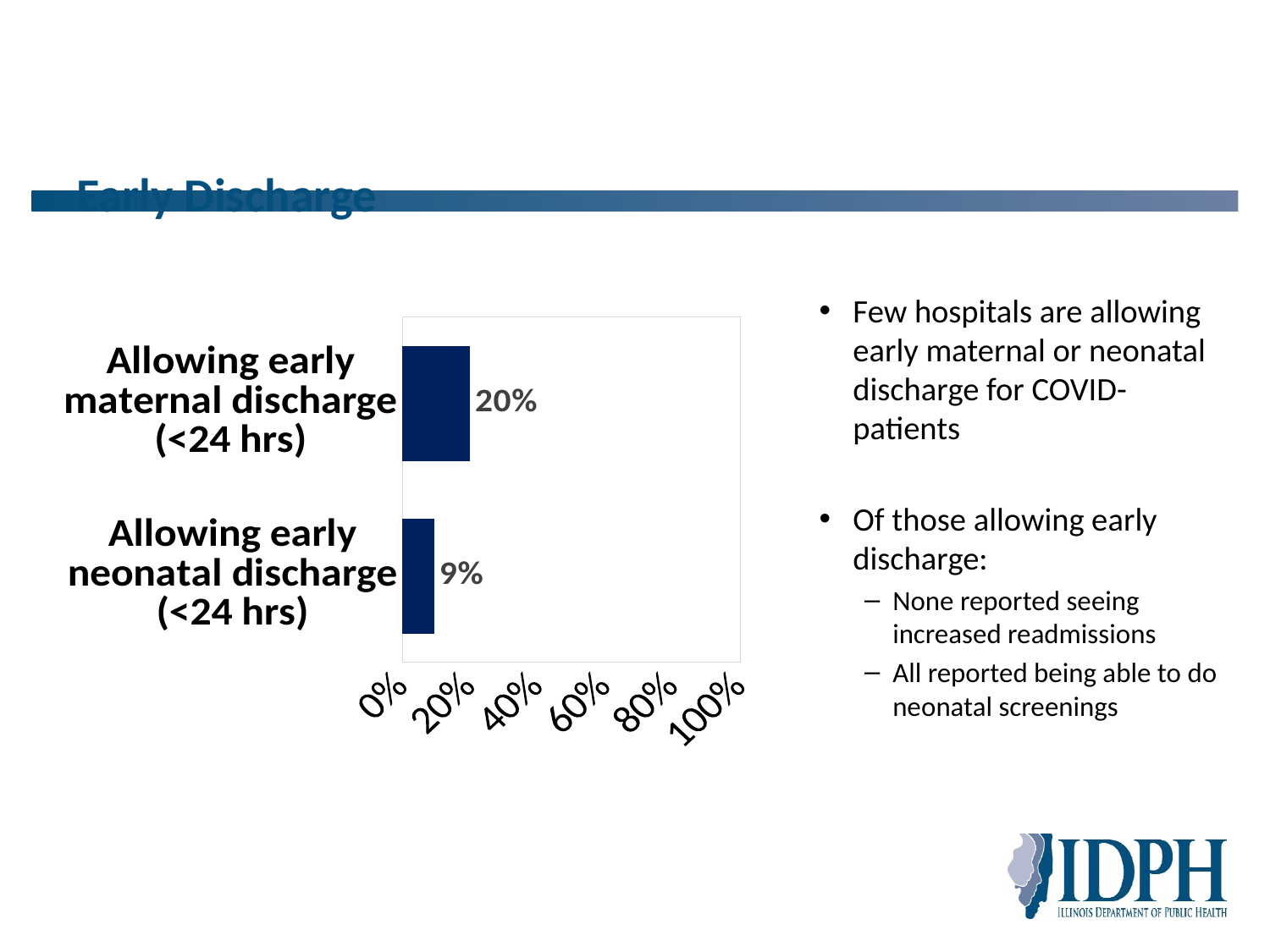
Which category has the higher value, early maternal discharge or early neonatal discharge? Allowing early maternal discharge (<24 hrs) What is the difference in percentage points between early maternal discharge and early neonatal discharge? 11 percentage points Is the value for allowing early neonatal discharge greater or less than 20%? less What percentage of hospitals are allowing early neonatal discharge (<24 hrs)? 9% What is the maximum value shown on the chart's percentage axis? 100% Is the value for allowing early maternal discharge greater or less than 40%? less What is the title of the slide containing the chart? Early Discharge What percentage of hospitals are allowing early maternal discharge (<24 hrs)? 20% What kind of chart is shown on the slide? Bar chart Which category has the lowest value in the chart? Allowing early neonatal discharge (<24 hrs) How many categories are shown in the chart? 2